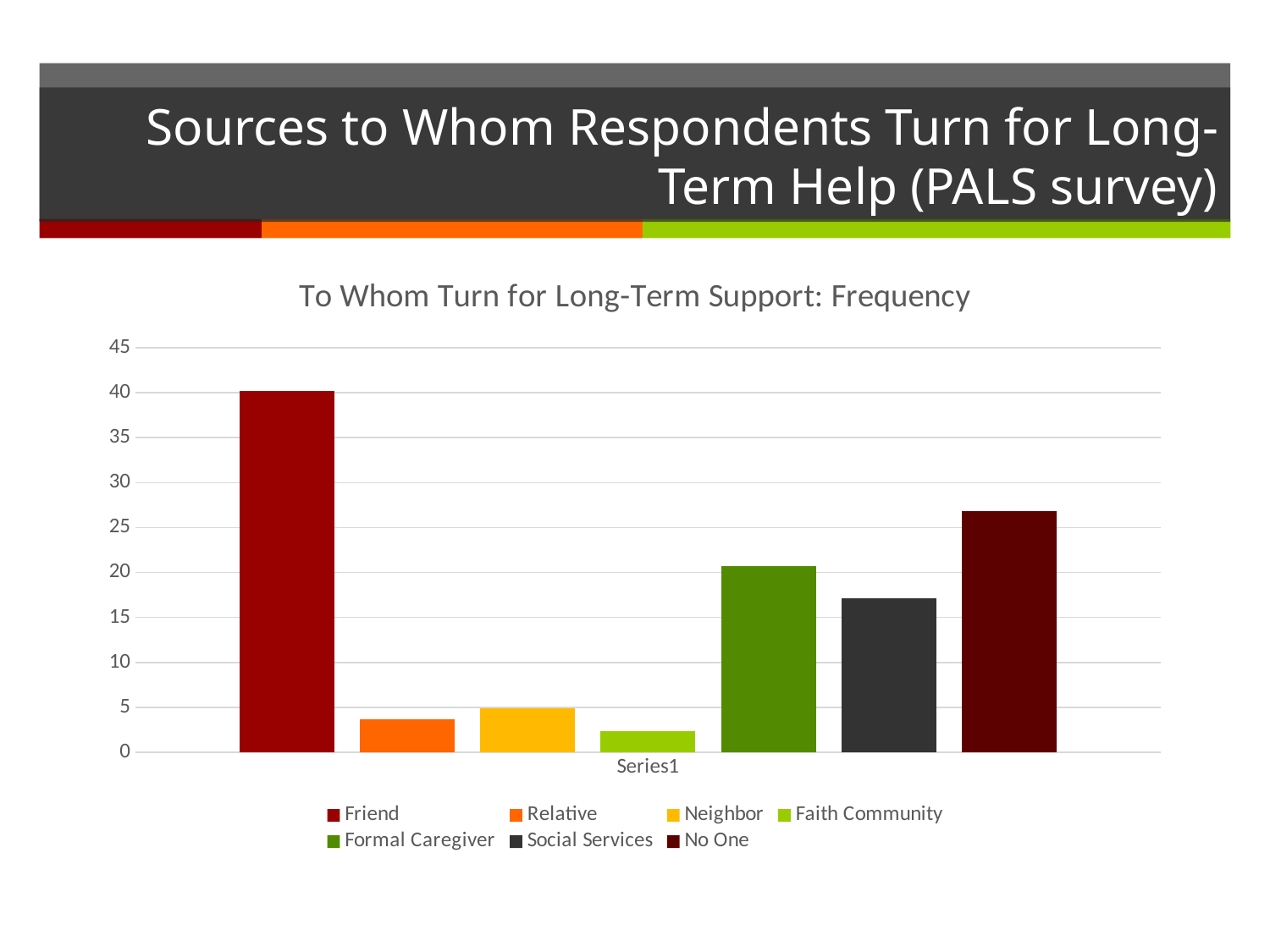
Which is larger, the value for Formal Caregiver or the value for Social Services? Formal Caregiver What kind of chart is shown on the slide? bar chart Which is larger, the value for No One or the value for Formal Caregiver? No One Is the value for Relative greater or less than 5? less Which source has the highest frequency? Friend What is the title of the chart? To Whom Turn for Long-Term Support: Frequency Is the value for Social Services greater or less than 20? less How many entries does the legend list? 7 Is the value for No One greater or less than 25? greater How many bars are plotted in the chart? 7 Which source has the lowest frequency? Faith Community